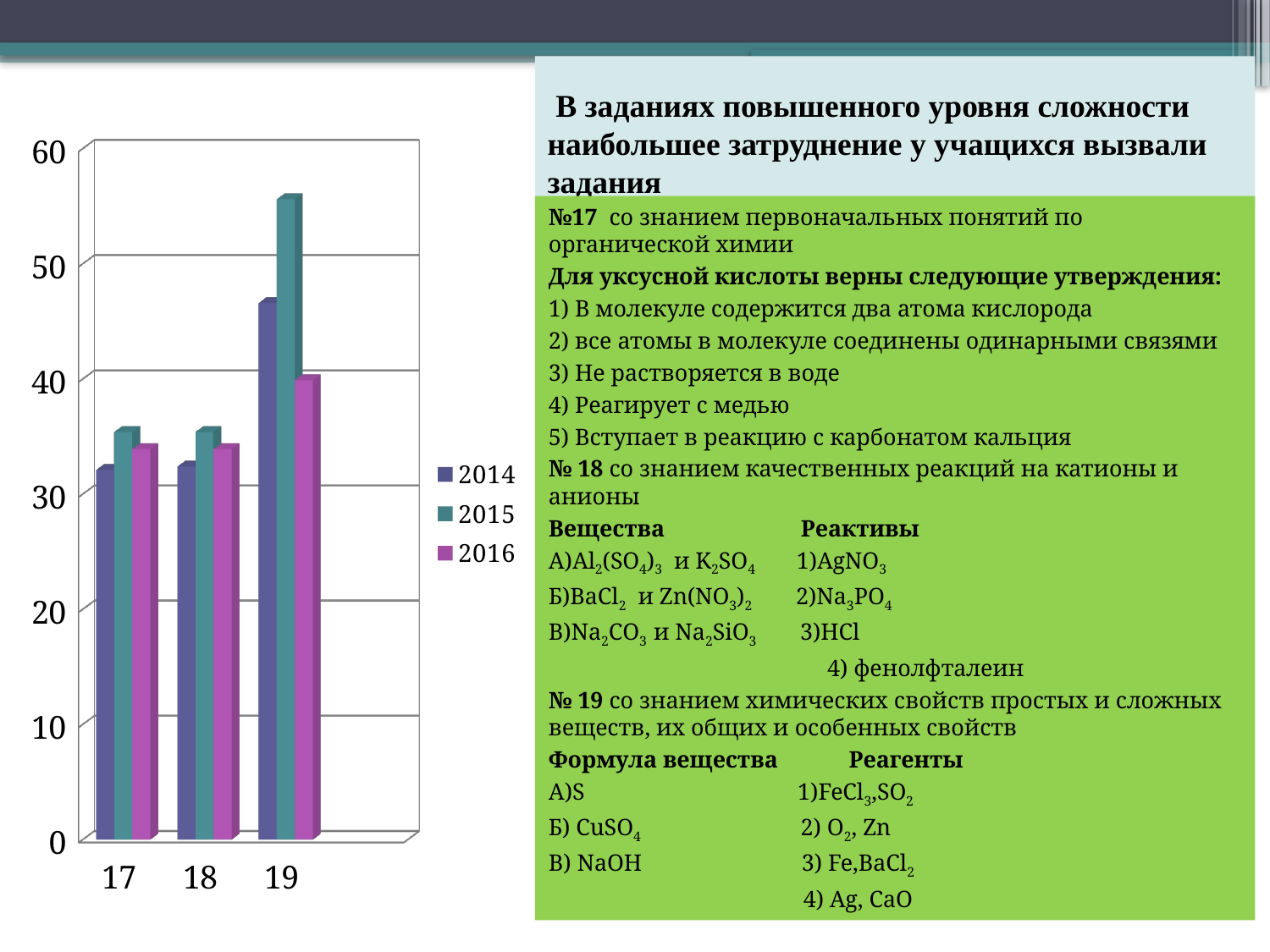
Which category has the highest value for the 2015 series? 19 Is the value for 2016 in category 18 greater or less than 40? less How many categories are shown on the x axis of the chart? 3 Is the value for 2014 in category 19 greater or less than 50? less Which category has the highest value for the 2014 series? 19 What kind of chart is shown on the slide? bar chart Is the value for 2014 in category 17 greater or less than 30? greater In category 19, which is larger: the value for 2015 or the value for 2016? 2015 How many series does the chart's legend list? 3 Which series in the chart is shown in purple/magenta bars? 2016 Which series are listed in the chart's legend? 2014, 2015, 2016